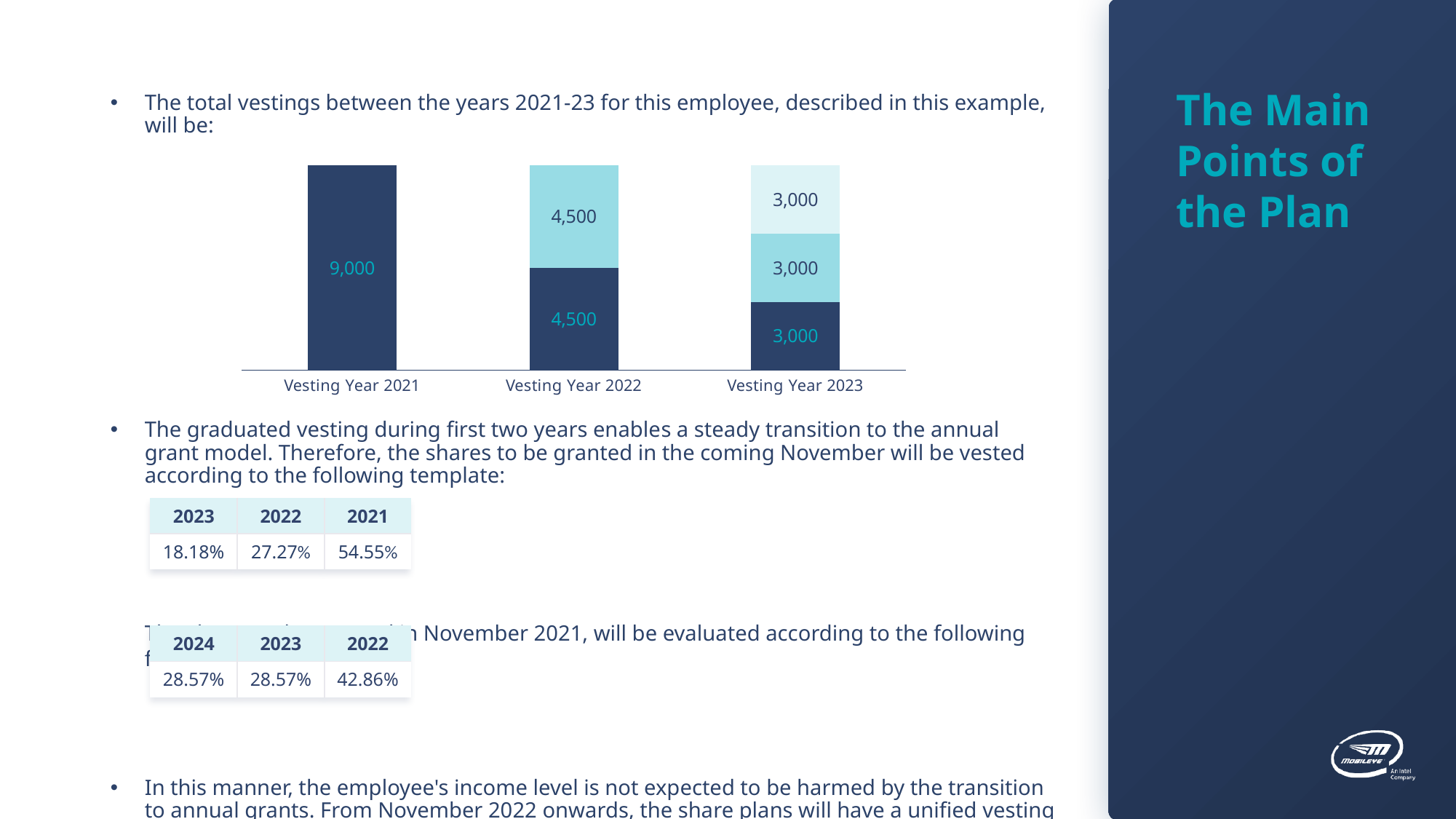
What is the difference between the bottom segment of Vesting Year 2022 and the bottom segment of Vesting Year 2023? 1,500 How many vesting years are shown on the x axis of the chart? 3 What is the total of the stacked bar for Vesting Year 2022? 9,000 What is the value of the bottom (dark blue) segment for Vesting Year 2022? 4,500 What type of chart is shown on the slide? stacked bar chart What is the value of the single bar segment for Vesting Year 2021? 9,000 What is the total of the stacked bar for Vesting Year 2023? 9,000 Which is larger: the bottom segment for Vesting Year 2021 or the bottom segment for Vesting Year 2022? Vesting Year 2021 What is the value of the bottom (dark blue) segment for Vesting Year 2023? 3,000 What is the value of the middle segment for Vesting Year 2023? 3,000 What is the value of the top (light blue) segment for Vesting Year 2022? 4,500 How many segments make up the bar for Vesting Year 2023? 3